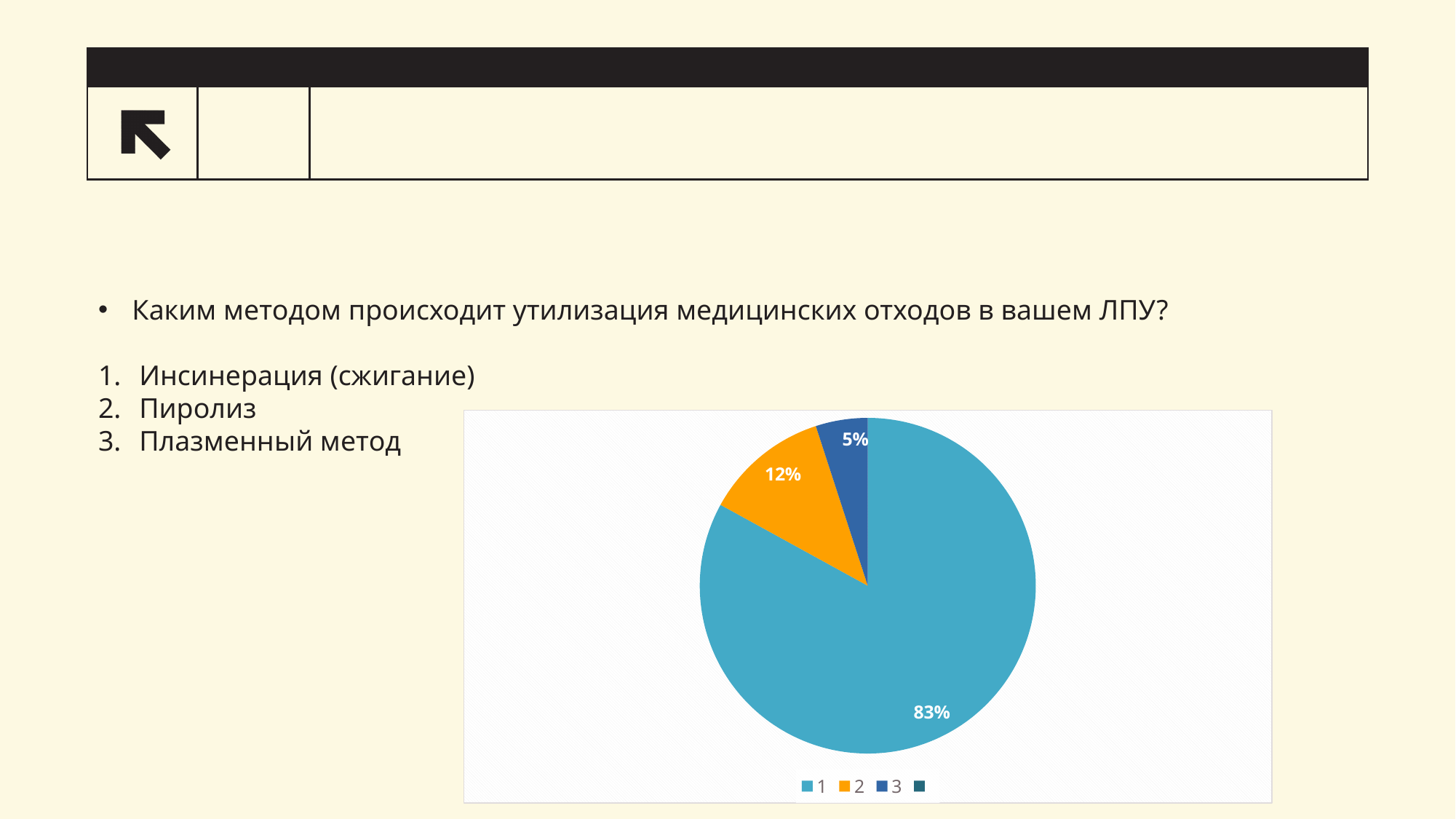
Which category has the largest slice in the pie chart? 1 What colour is the largest slice of the pie chart? light blue What percentage does slice 2 of the pie chart represent? 12% By how many percentage points does slice 2 exceed slice 3 in the pie chart? 7 percentage points Which legend entry corresponds to the orange slice of the pie chart? 2 By how many percentage points does slice 1 exceed slice 2 in the pie chart? 71 percentage points Which is larger in the pie chart, slice 2 or slice 3? 2 How many slices with data labels are shown in the pie chart? 3 What percentage does slice 3 of the pie chart represent? 5% What kind of chart is shown on the slide? pie chart Which category has the smallest slice in the pie chart? 3 What percentage does slice 1 of the pie chart represent? 83%